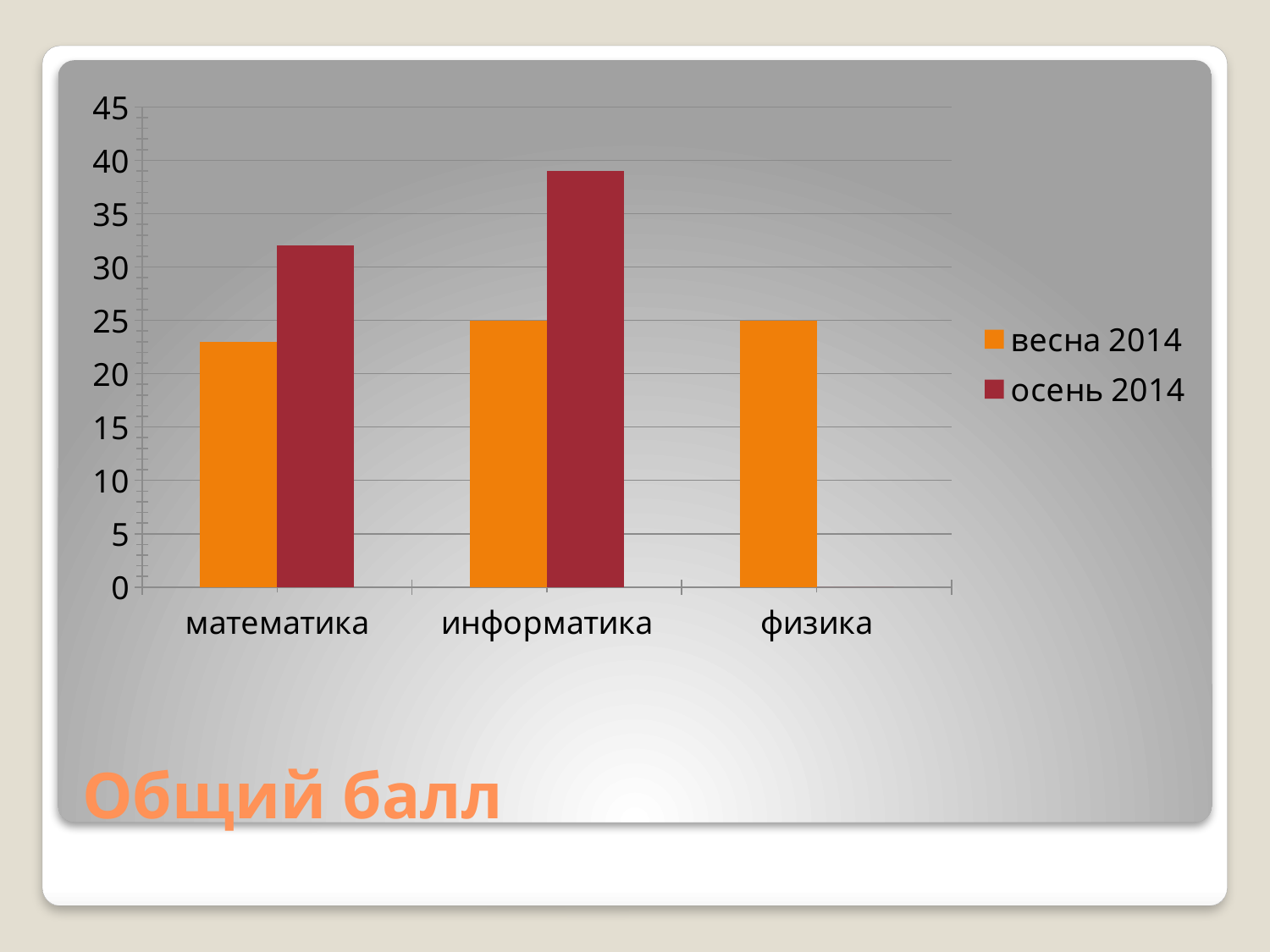
Is the value for информатика in the осень 2014 series greater or less than 35? greater Is the value for математика in the осень 2014 series greater or less than 30? greater Which category has the highest value for the осень 2014 series? информатика For математика, which series has the larger value, весна 2014 or осень 2014? осень 2014 Which series is shown in orange in the chart? весна 2014 Is the value for математика in the весна 2014 series greater or less than 25? less How many categories are shown on the x axis of the chart? 3 Which category has the lowest value for the весна 2014 series? математика How many series does the chart's legend list? 2 What kind of chart is shown on the slide? bar chart What is the title of the chart? Общий балл